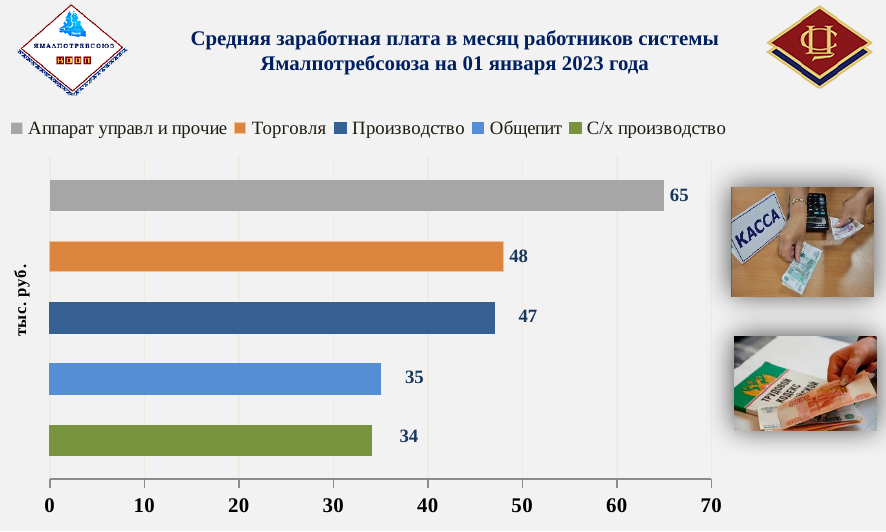
What value is shown for С/х производство? 34 Which category has the lowest value on the chart? С/х производство What is the difference between the values for Производство and Общепит? 12 Which category has the highest value on the chart? Аппарат управл и прочие How many entries does the legend list? 5 How many categories are plotted on the chart? 5 What is the average monthly salary value shown for Торговля? 48 What type of chart is shown on the slide? Bar chart What is the difference between the values for Аппарат управл и прочие and Торговля? 17 Which is larger, the value for Торговля or the value for Производство? Торговля What unit is given on the vertical axis label of the chart? тыс. руб. What value is shown for Общепит? 35